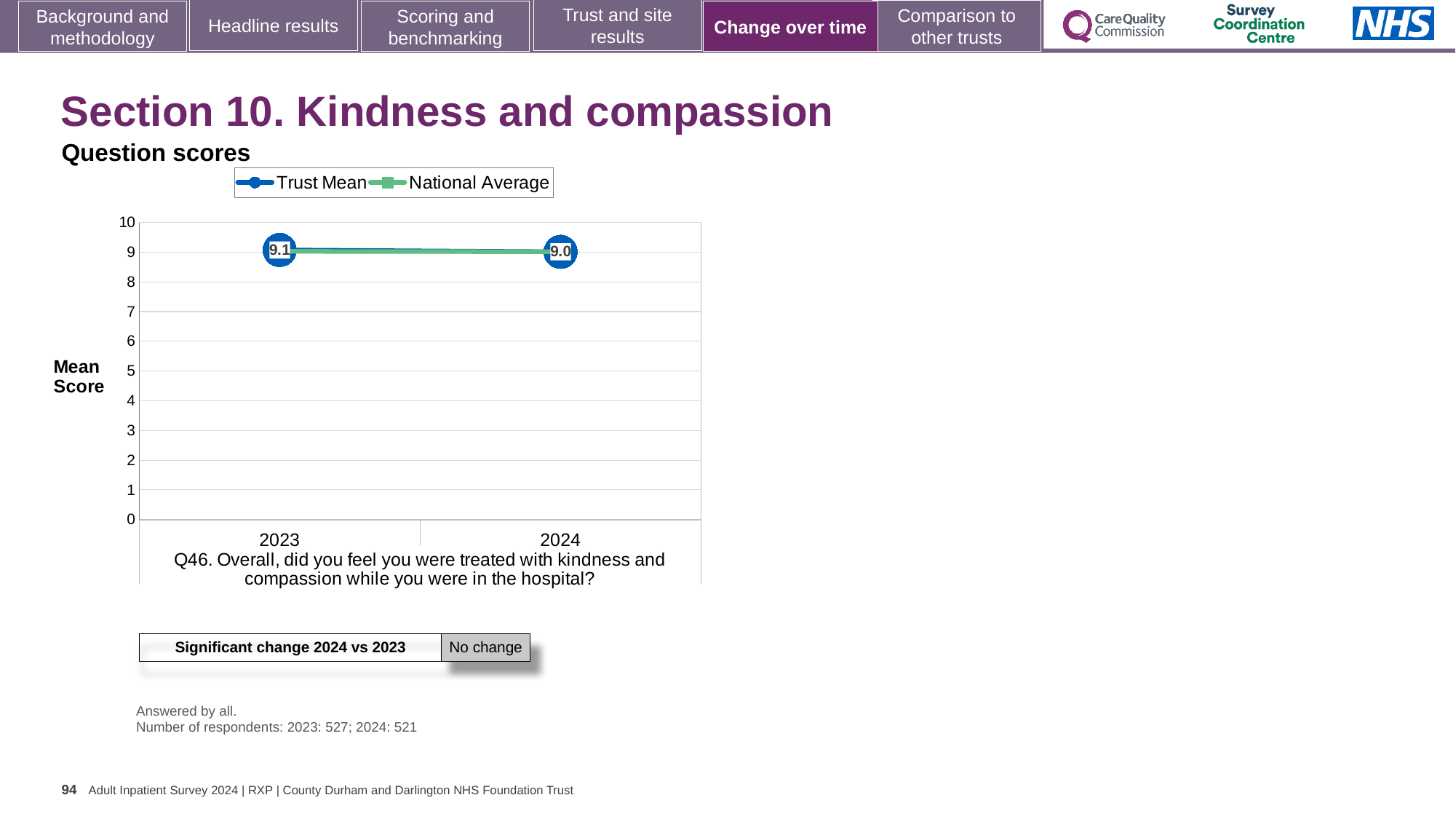
Does the Trust Mean rise or fall from 2023 to 2024? Fall What is the difference between the Trust Mean scores for 2023 and 2024? 0.1 What is the Trust Mean score for 2023? 9.1 How many years are shown on the x axis of the chart? 2 What kind of chart is shown on the slide? Line chart In which year is the Trust Mean score higher? 2023 How many series does the chart legend list? 2 What is the Trust Mean score for 2024? 9.0 In which year is the Trust Mean score lower? 2024 Is the Trust Mean value for 2024 greater or less than 5? greater What are the two series named in the chart legend? Trust Mean and National Average Which is larger, the Trust Mean for 2023 or for 2024? 2023